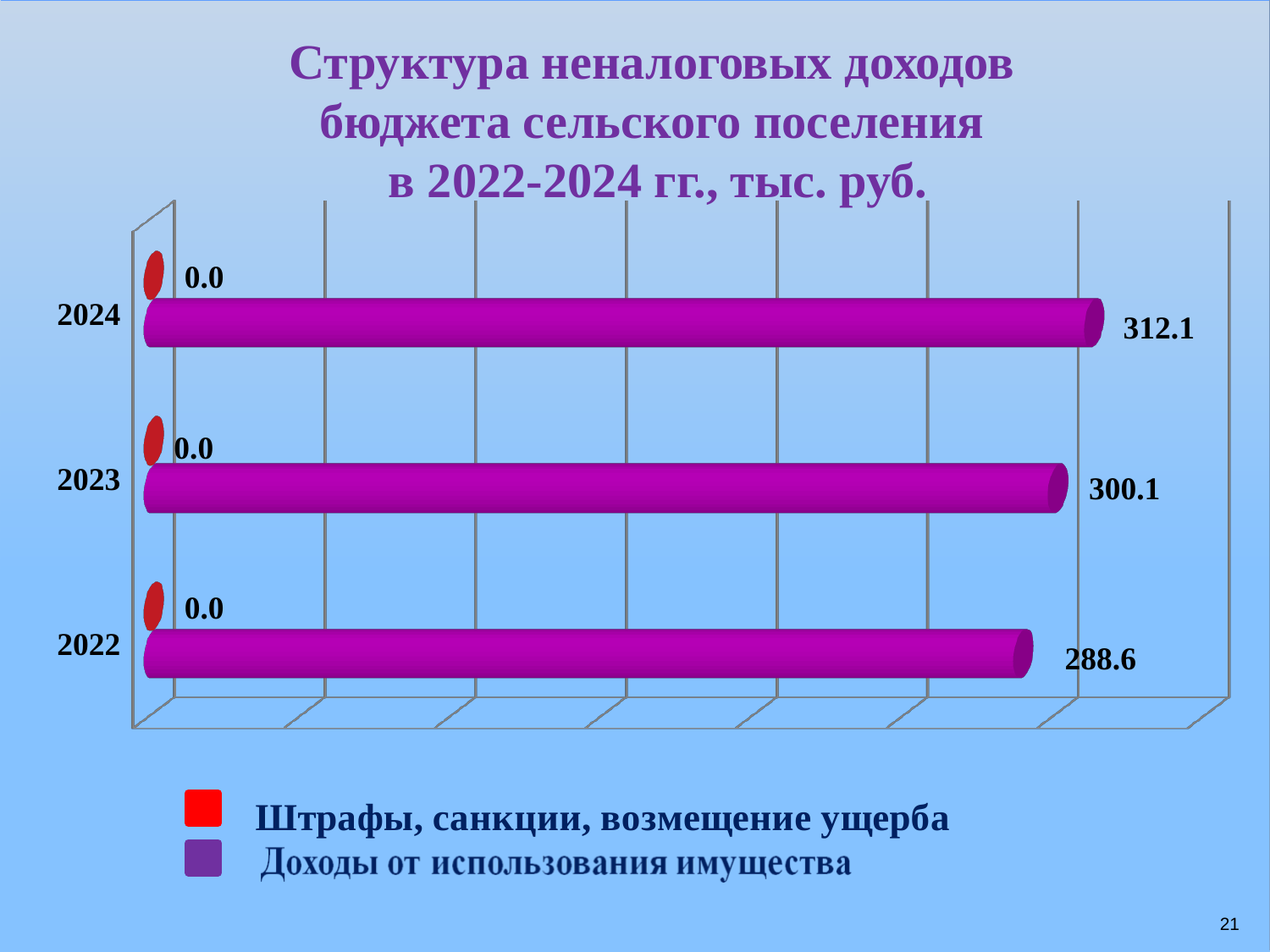
What is the value of 'Доходы от использования имущества' for 2024? 312.1 What is the value of 'Доходы от использования имущества' for 2022? 288.6 In which year is 'Доходы от использования имущества' the lowest? 2022 Which is larger: 'Доходы от использования имущества' in 2023 or in 2024? 2024 How many series does the legend list? 2 In which year is 'Доходы от использования имущества' the highest? 2024 What is the value of 'Доходы от использования имущества' for 2023? 300.1 What is the difference between 'Доходы от использования имущества' in 2024 and in 2022? 23.5 What is the value of 'Штрафы, санкции, возмещение ущерба' for 2023? 0.0 What is the difference between 'Доходы от использования имущества' in 2023 and in 2022? 11.5 How many years are shown on the chart? 3 What kind of chart is shown on the slide? Bar chart